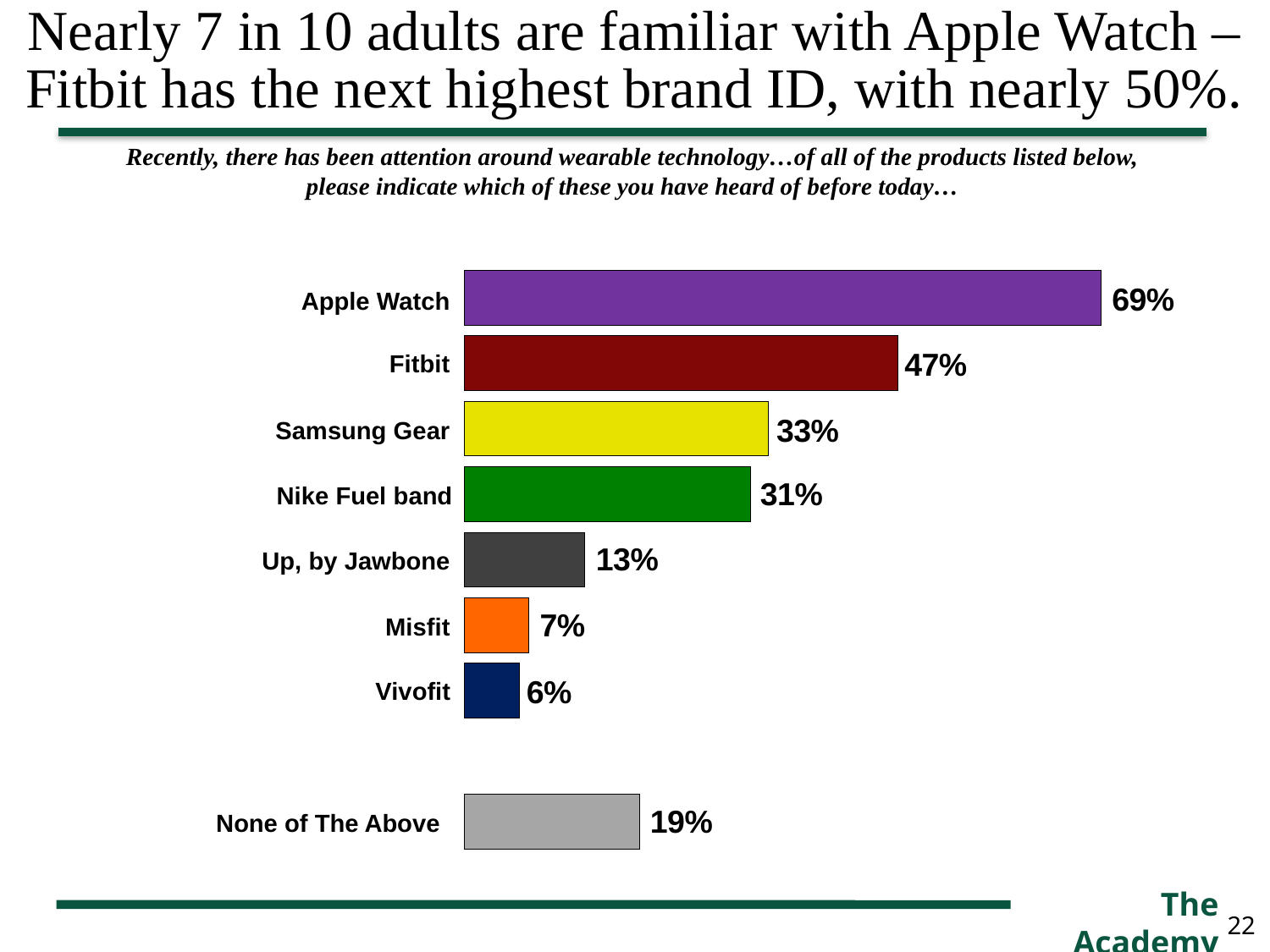
Which product has the lowest brand awareness? Vivofit What is the difference between the values for Apple Watch and Fitbit? 22% What percentage of adults have heard of Apple Watch? 69% What type of chart is shown on the slide? Bar chart Which has a higher value, Up, by Jawbone or None of The Above? None of The Above What is the difference between the values for Samsung Gear and Nike Fuel band? 2% Which has a higher value, Misfit or Vivofit? Misfit What percentage is shown for Up, by Jawbone? 13% What is the value shown for Fitbit? 47% Which product has the highest brand awareness? Apple Watch How many bars are shown in the chart? 8 What is the value for None of The Above? 19%